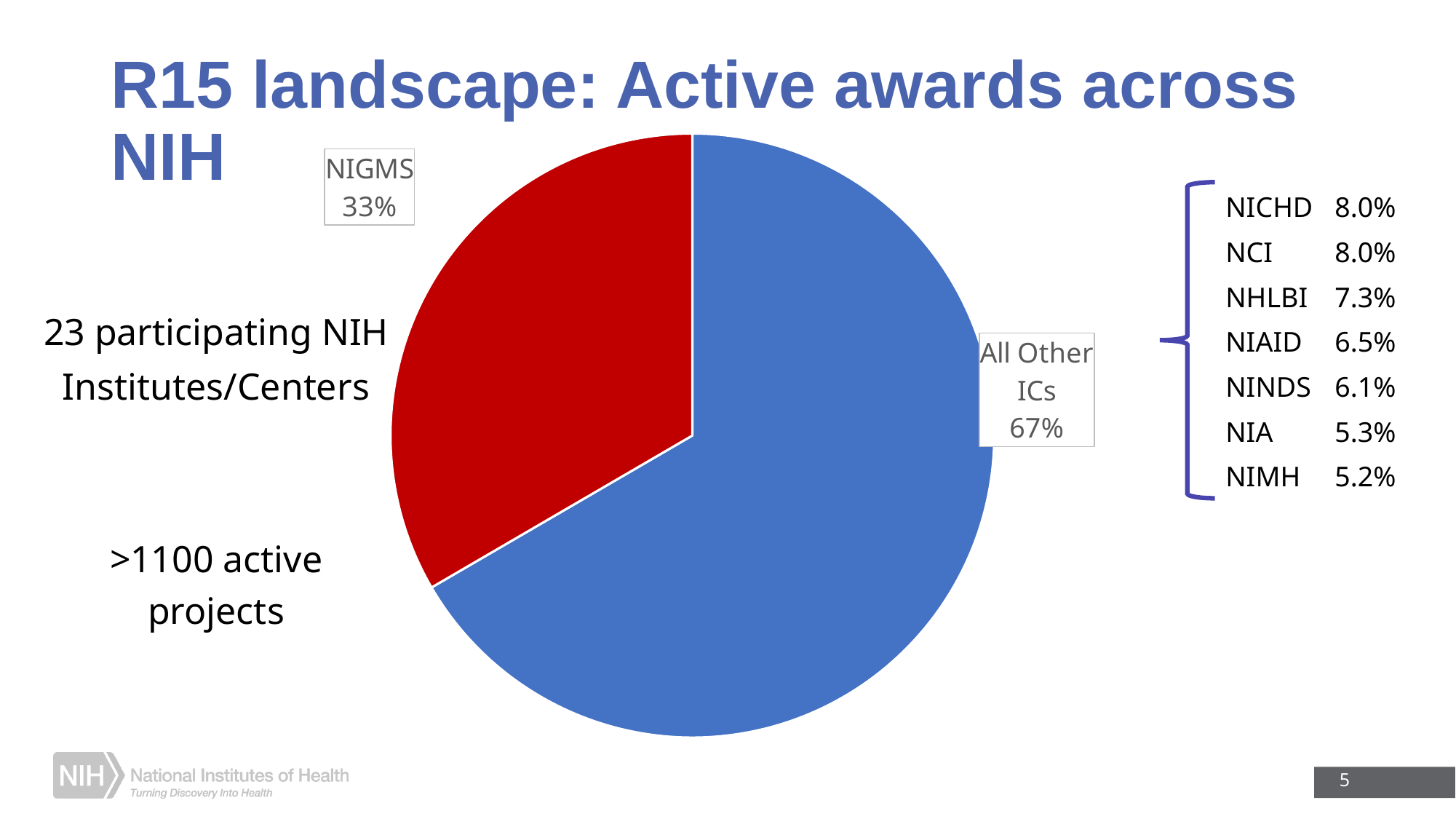
In the breakdown of All Other ICs listed beside the pie, which institute has the lowest percentage? NIMH What kind of chart is shown on the slide? pie chart Which slice of the pie is the largest? All Other ICs What share of the pie does NIGMS account for? 33% What colour is the NIGMS slice of the pie? red What share of the pie does All Other ICs account for? 67% In the breakdown of All Other ICs listed beside the pie, what percentage is shown for NHLBI? 7.3% What is the difference in percentage points between the All Other ICs slice and the NIGMS slice? 34 Which is larger, the NIGMS slice or the All Other ICs slice? All Other ICs What is the title of the slide containing the pie chart? R15 landscape: Active awards across NIH How many slices does the pie chart have? 2 Which slice of the pie is the smallest? NIGMS